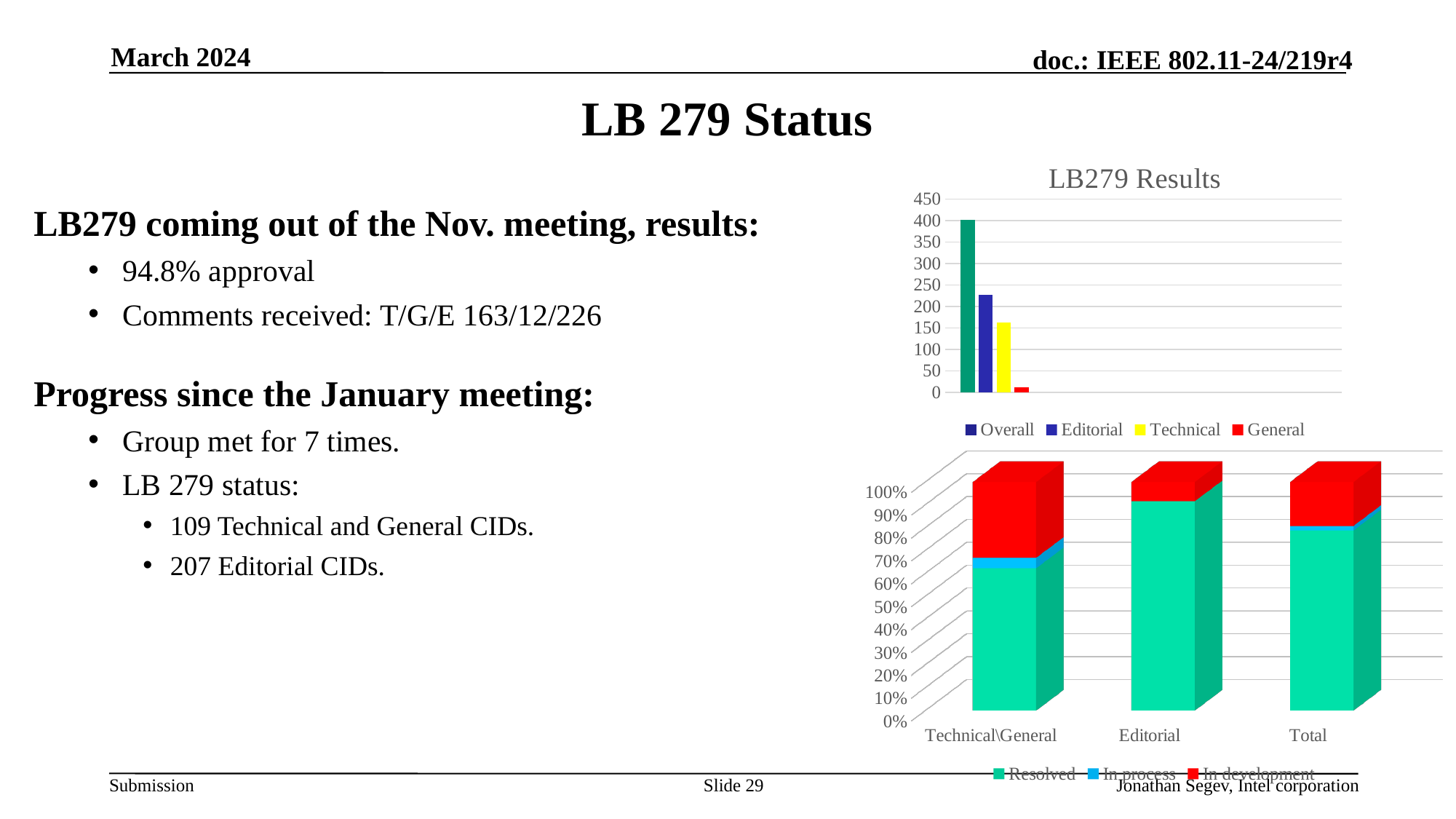
In the 'LB279 Results' chart, is the value for Editorial greater or less than 200? greater In the stacked bar chart at the bottom right, is the Resolved share for Technical\General greater or less than 50%? greater How many series does the legend of the 'LB279 Results' chart list? 4 How many categories are shown on the x axis of the stacked bar chart at the bottom right? 3 In the stacked bar chart at the bottom right, which category has the largest Resolved share? Editorial How many series does the legend of the stacked bar chart at the bottom right list? 3 In the 'LB279 Results' chart, is the value for Technical greater or less than 200? less In the 'LB279 Results' chart, which series has the lowest value? General What kind of chart is the 'LB279 Results' chart? bar chart In the 'LB279 Results' chart, which series has the highest value? Overall In the 'LB279 Results' chart, which is larger, the Editorial value or the Technical value? Editorial